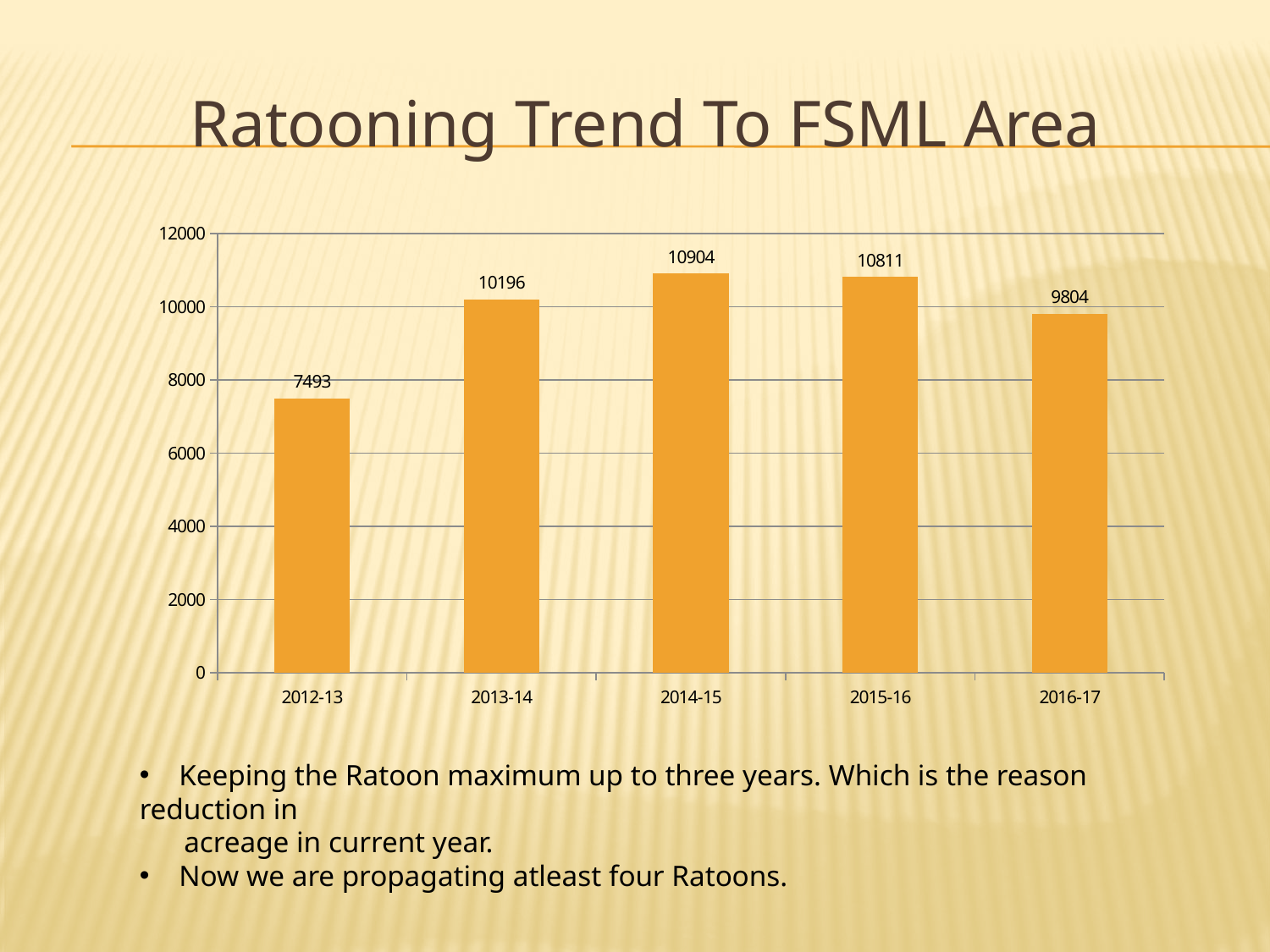
What is the value for 2012-13? 7493 Which year has the lowest value? 2012-13 Is the value for 2012-13 greater or less than 8000? less What is the value for 2016-17? 9804 Which is larger, the value for 2013-14 or the value for 2016-17? 2013-14 What kind of chart is shown on the slide? bar chart What is the value for 2014-15? 10904 How many years are shown on the x axis? 5 What is the title of the slide containing the chart? Ratooning Trend To FSML Area What is the difference between the values for 2013-14 and 2012-13? 2703 What is the difference between the values for 2015-16 and 2016-17? 1007 Which year has the highest value? 2014-15